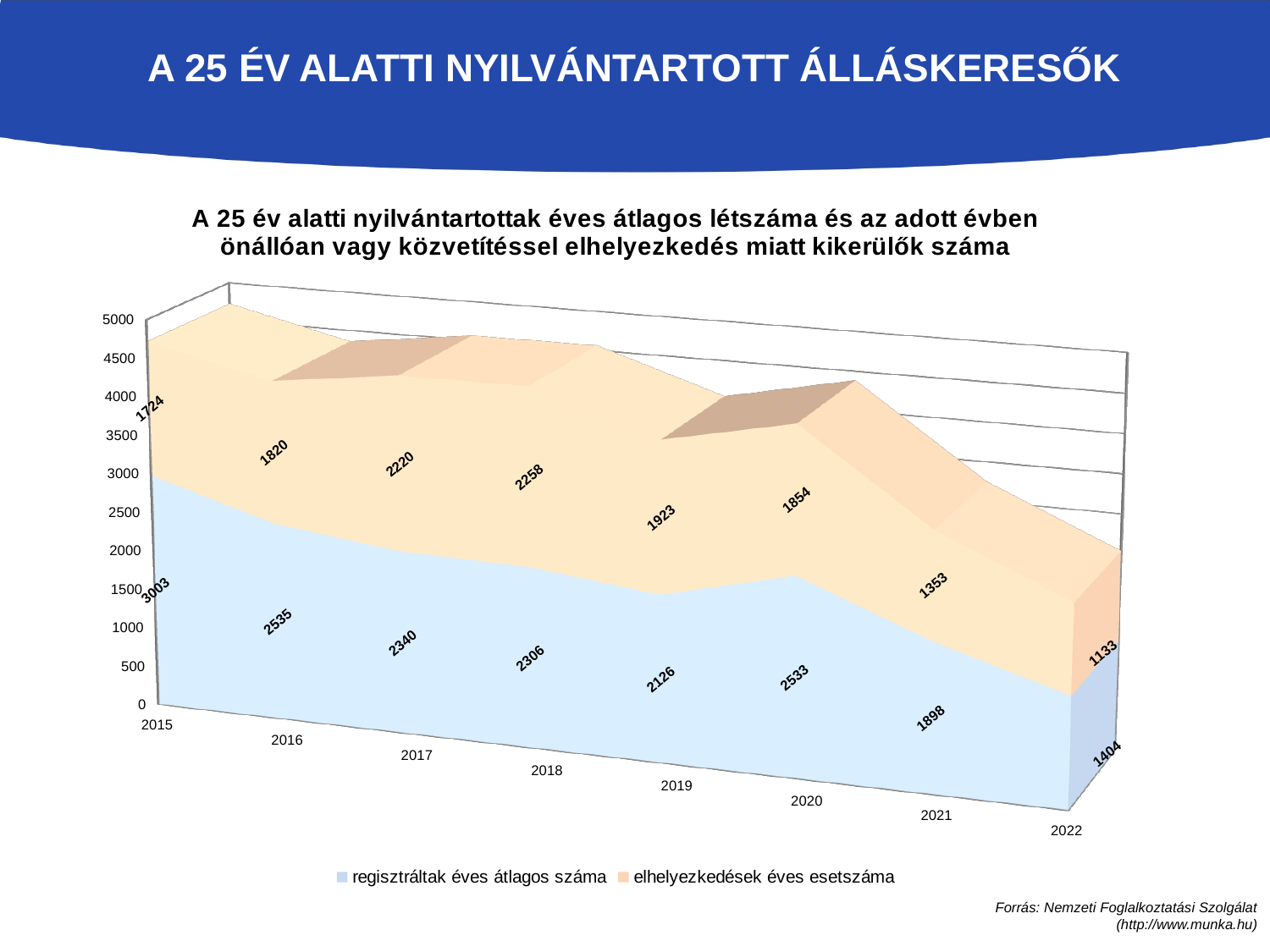
How many years are shown on the x axis? 8 What is the value of 'regisztráltak éves átlagos száma' for 2015? 3003 What is the value of 'regisztráltak éves átlagos száma' for 2022? 1404 In which year is 'elhelyezkedések éves esetszáma' the lowest? 2022 What kind of chart is shown? Area chart How many series does the legend list? 2 What is the value of 'elhelyezkedések éves esetszáma' for 2018? 2258 What is the difference between 'regisztráltak éves átlagos száma' in 2015 and in 2022? 1599 What is the value of 'elhelyezkedések éves esetszáma' for 2021? 1353 Which is larger: 'elhelyezkedések éves esetszáma' in 2017 or in 2019? 2017 In which year is 'regisztráltak éves átlagos száma' the highest? 2015 What is the total of the two series for 2020? 4387